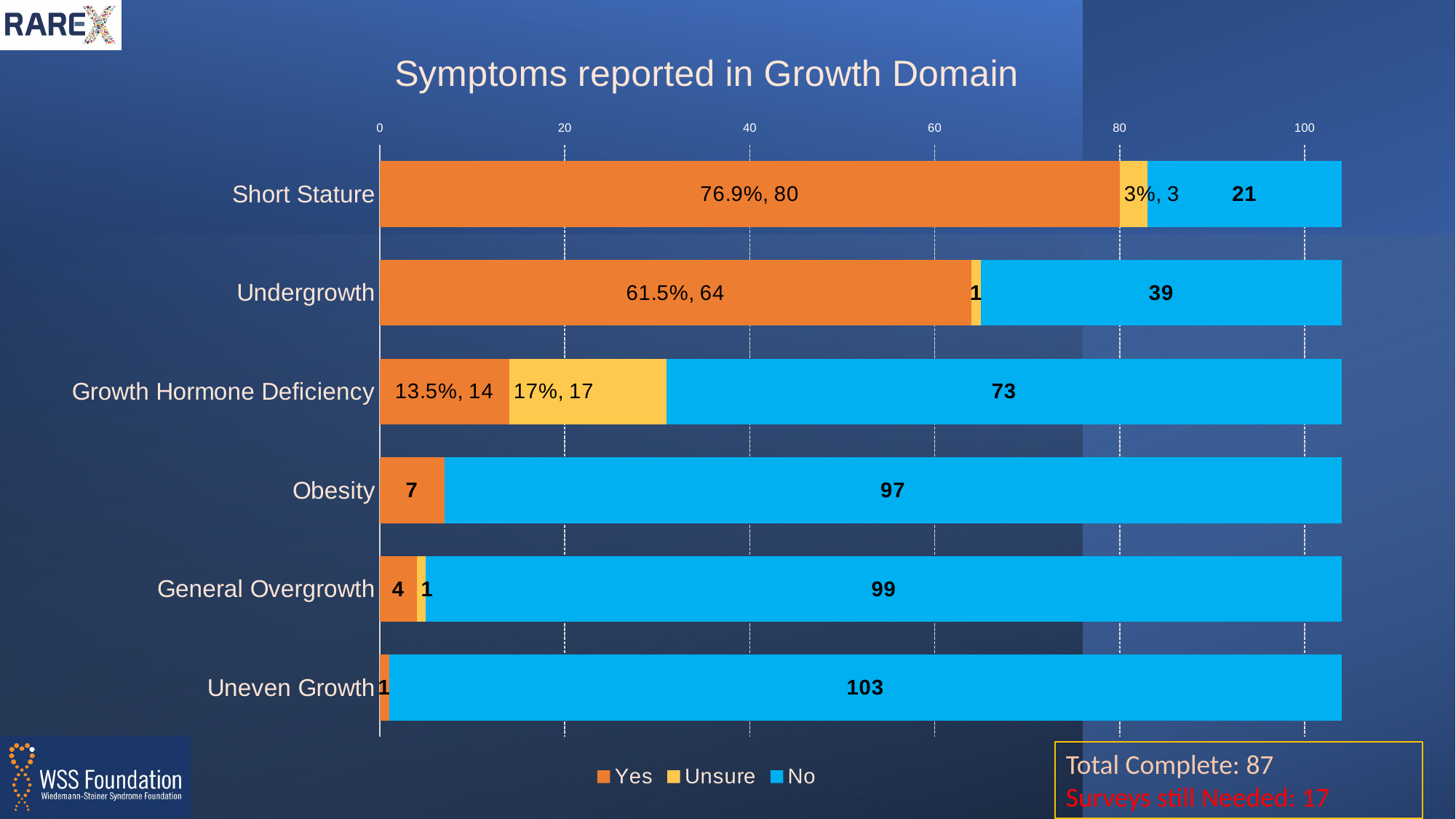
What is the title of the chart? Symptoms reported in Growth Domain Which symptom has the highest 'Yes' value? Short Stature What is the 'Yes' value for Short Stature? 80 What is the difference between the 'No' values for Uneven Growth and Undergrowth? 64 What is the total of the stacked bar for General Overgrowth? 104 Which is larger, the 'Yes' value for Undergrowth or the 'No' value for Growth Hormone Deficiency? No value for Growth Hormone Deficiency How many symptom categories are plotted in the chart? 6 What is the 'No' value for Obesity? 97 Which symptom has the lowest 'No' value? Short Stature How many series does the legend list? 3 What kind of chart is shown on the slide? Stacked bar chart What is the 'Unsure' value for Growth Hormone Deficiency? 17